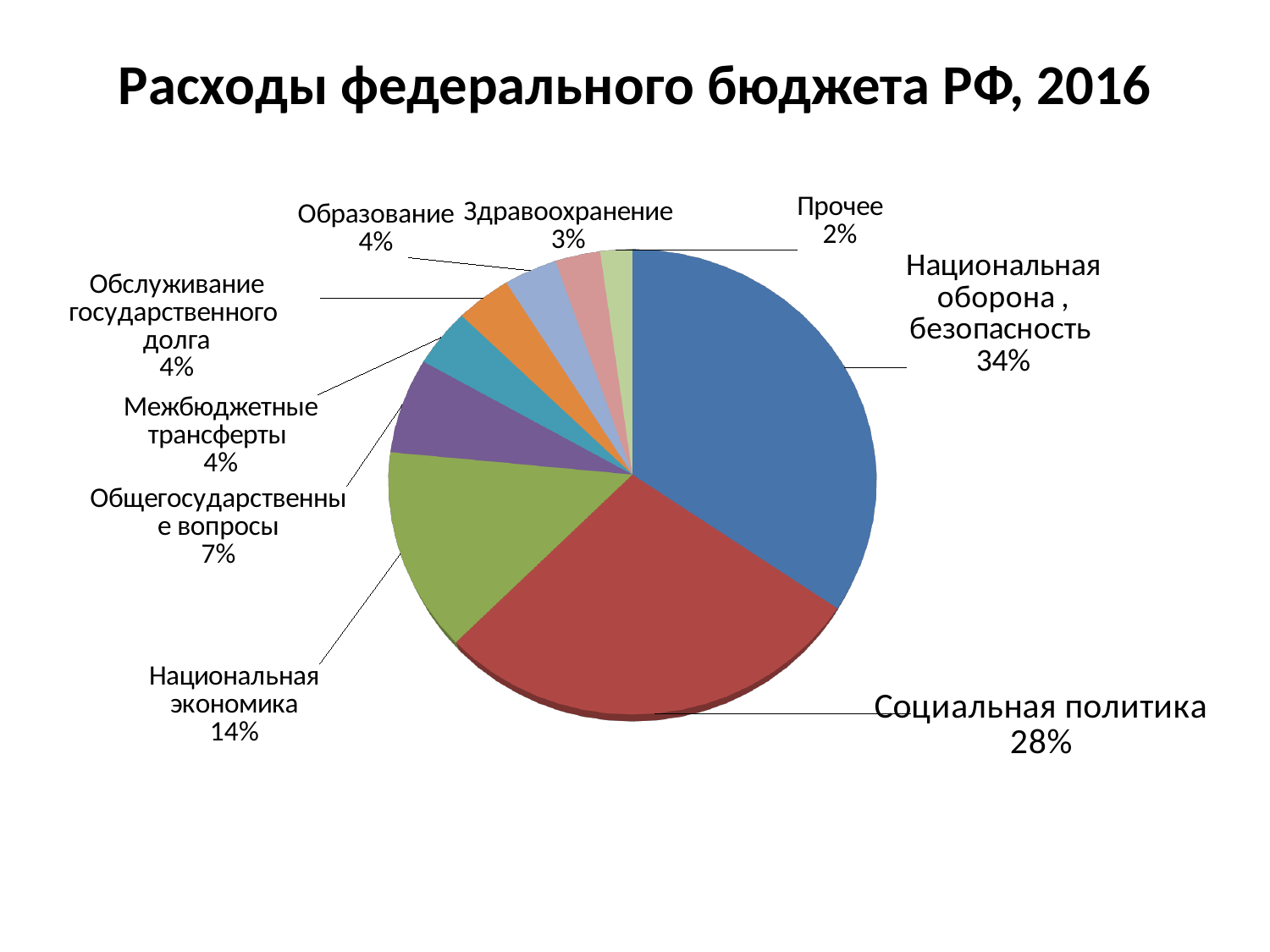
How many slices does the pie chart have? 9 What share of the pie is labelled for Общегосударственные вопросы? 7% Which category has the smallest slice of the pie? Прочее What share of the pie is labelled for Национальная экономика? 14% Which is larger, the share for Национальная экономика or the share for Общегосударственные вопросы? Национальная экономика Which category has the largest slice of the pie? Национальная оборона, безопасность What type of chart is shown on the slide? Pie chart What share of the pie is labelled for Социальная политика? 28% What is the title of the chart? Расходы федерального бюджета РФ, 2016 What is the difference in percentage points between Национальная оборона, безопасность and Социальная политика? 6 What is the combined share of Образование and Здравоохранение? 7%